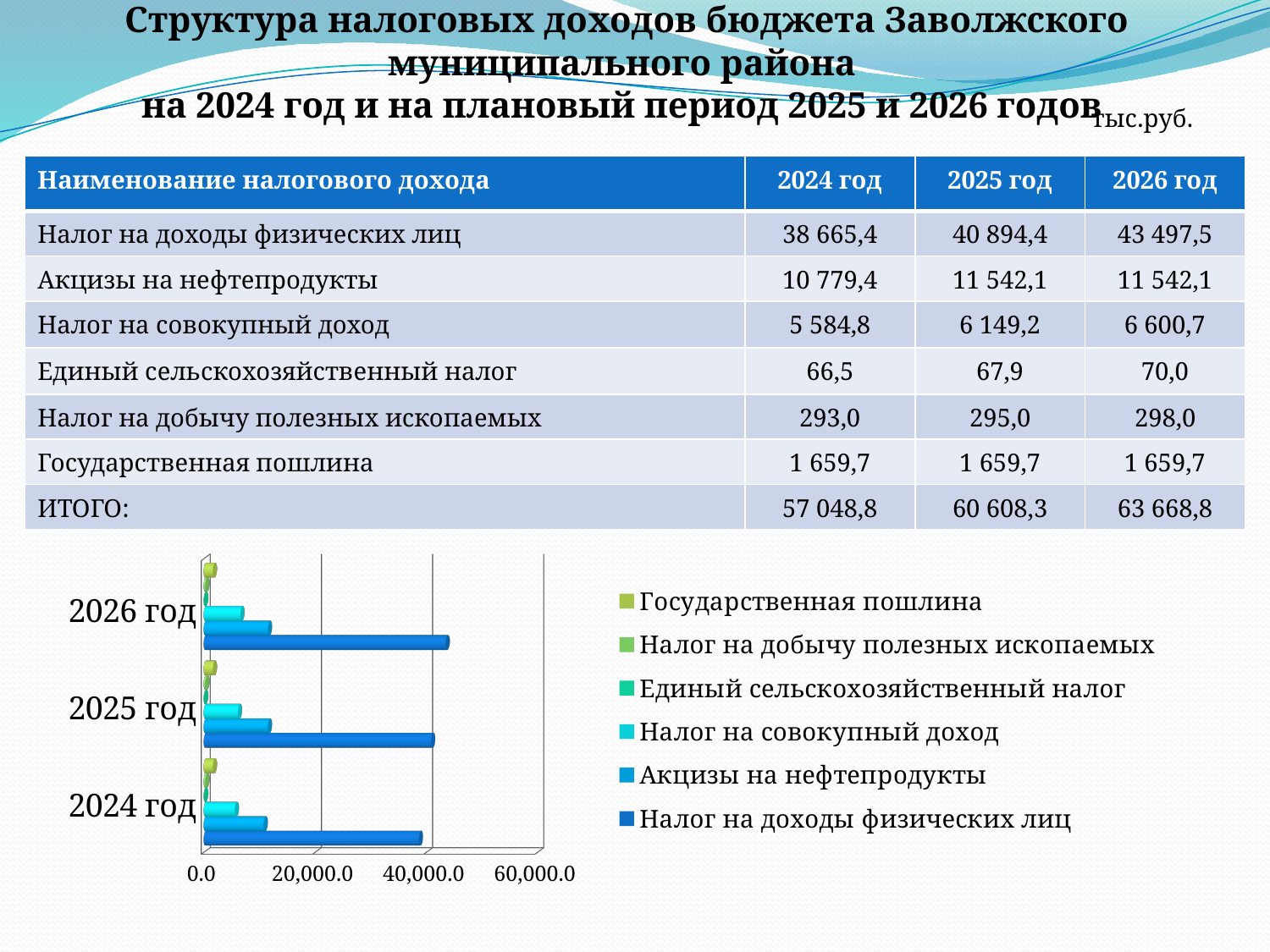
Which legend entry is shown in dark blue in the chart? Налог на доходы физических лиц According to the table on the slide, what is the value of Налог на доходы физических лиц for 2024 год? 38 665,4 Which series has the longest bar for 2026 год in the chart? Налог на доходы физических лиц What is the highest tick value shown on the chart's horizontal axis? 60,000.0 In the bar chart, is the value for Налог на доходы физических лиц in 2026 год greater or less than 40,000.0? greater What kind of chart is shown at the bottom of the slide? bar chart How many year categories does the bar chart show? 3 Do the bars for Налог на доходы физических лиц rise or fall from 2024 год to 2026 год? rise According to the table on the slide, what is the value of Акцизы на нефтепродукты for 2026 год? 11 542,1 How many series does the chart legend list? 6 In 2024 год, which is larger in the chart: Налог на доходы физических лиц or Акцизы на нефтепродукты? Налог на доходы физических лиц In the bar chart, is the value for Акцизы на нефтепродукты in 2025 год greater or less than 20,000.0? less